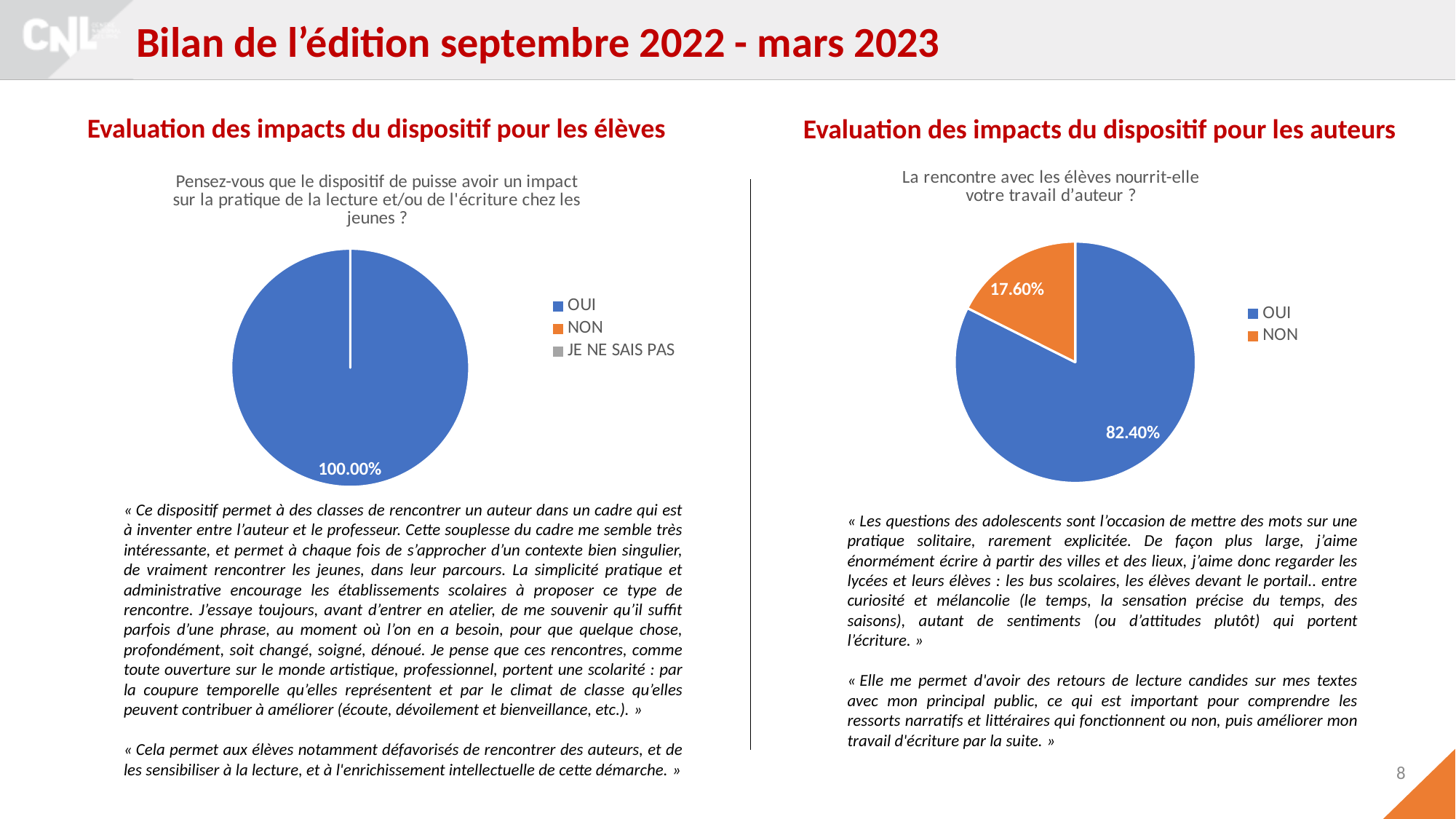
In the right pie chart, which category has the largest share? OUI In the right pie chart, what is the difference in percentage points between OUI and NON? 64.80% In the left pie chart, what percentage is shown for OUI? 100.00% What is the title of the right pie chart? La rencontre avec les élèves nourrit-elle votre travail d'auteur ? How many entries does the legend of the left pie chart list? 3 In the right pie chart, which category has the smallest share? NON How many entries does the legend of the right pie chart list? 2 In the right pie chart, what percentage is shown for NON? 17.60% What type of chart is shown on the left side of the slide? pie chart In the left pie chart, which category accounts for the entire pie? OUI In the right pie chart, which colour represents NON? orange In the right pie chart, what percentage is shown for OUI? 82.40%